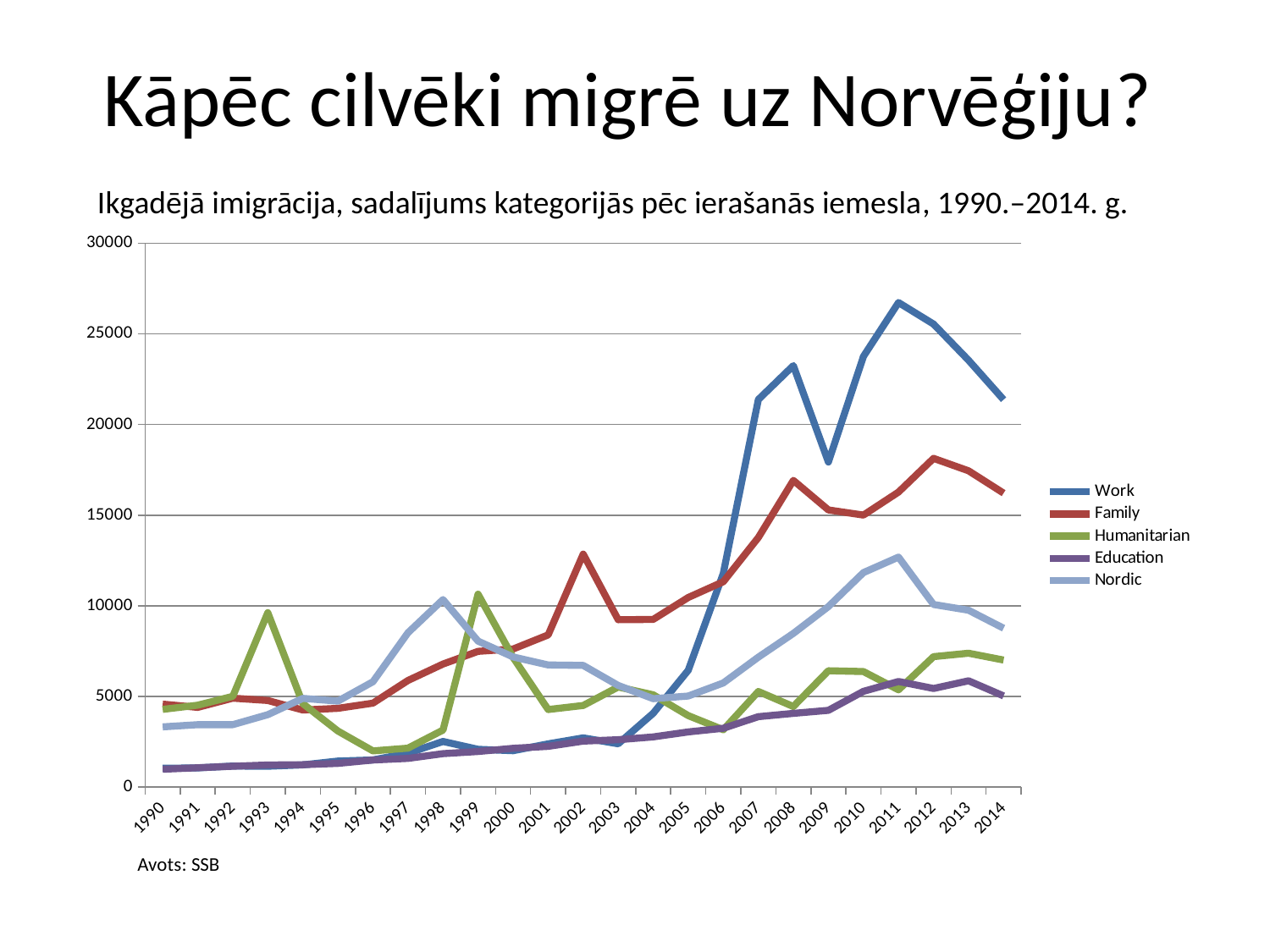
Does the Work series rise or fall between 2011 and 2014? fall What kind of chart is shown on the slide? line chart Is the value for Family in 2014 greater or less than 15000? greater Is the value for Nordic in 1990 greater or less than 5000? less Which series has the highest value in 2011? Work How many years are plotted along the x axis? 25 What source is cited below the chart? SSB How many series does the legend list? 5 Is the value for Work in 2011 greater or less than 25000? greater Which is larger in 1993, Humanitarian or Work? Humanitarian Which series has the lowest value in 2014? Education Which is larger in 2002, Family or Nordic? Family